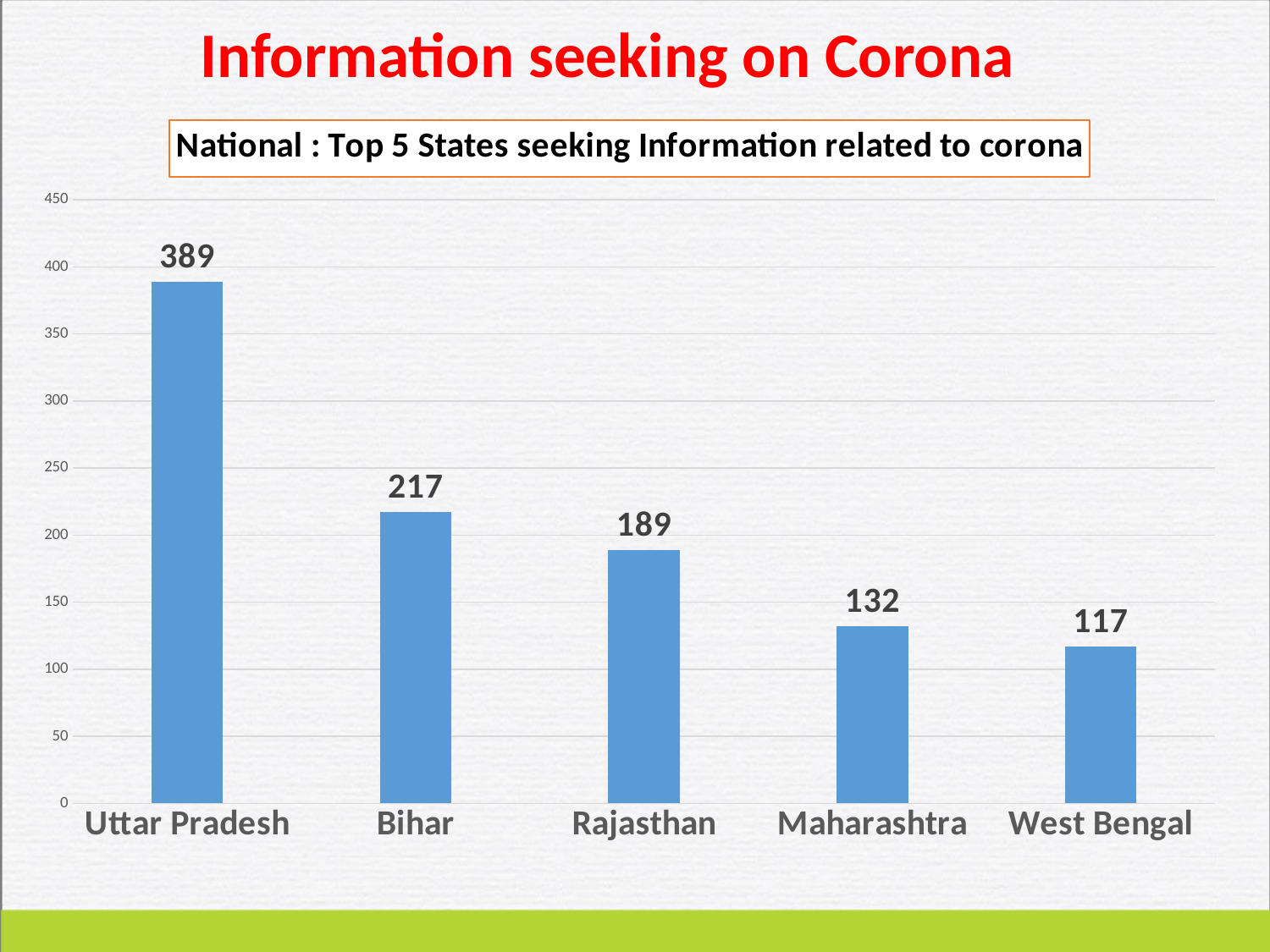
What is the value for Rajasthan? 189 What is the value for Maharashtra? 132 What is the value for Uttar Pradesh? 389 What kind of chart is shown on the slide? Bar chart How many states are shown in the chart? 5 What is the title shown in the box above the chart? National : Top 5 States seeking Information related to corona Which state has the lowest value? West Bengal What is the value for Bihar? 217 Which is larger, the value for Rajasthan or the value for Maharashtra? Rajasthan Which state has the highest value? Uttar Pradesh What is the value for West Bengal? 117 What is the difference between the values for Uttar Pradesh and Bihar? 172